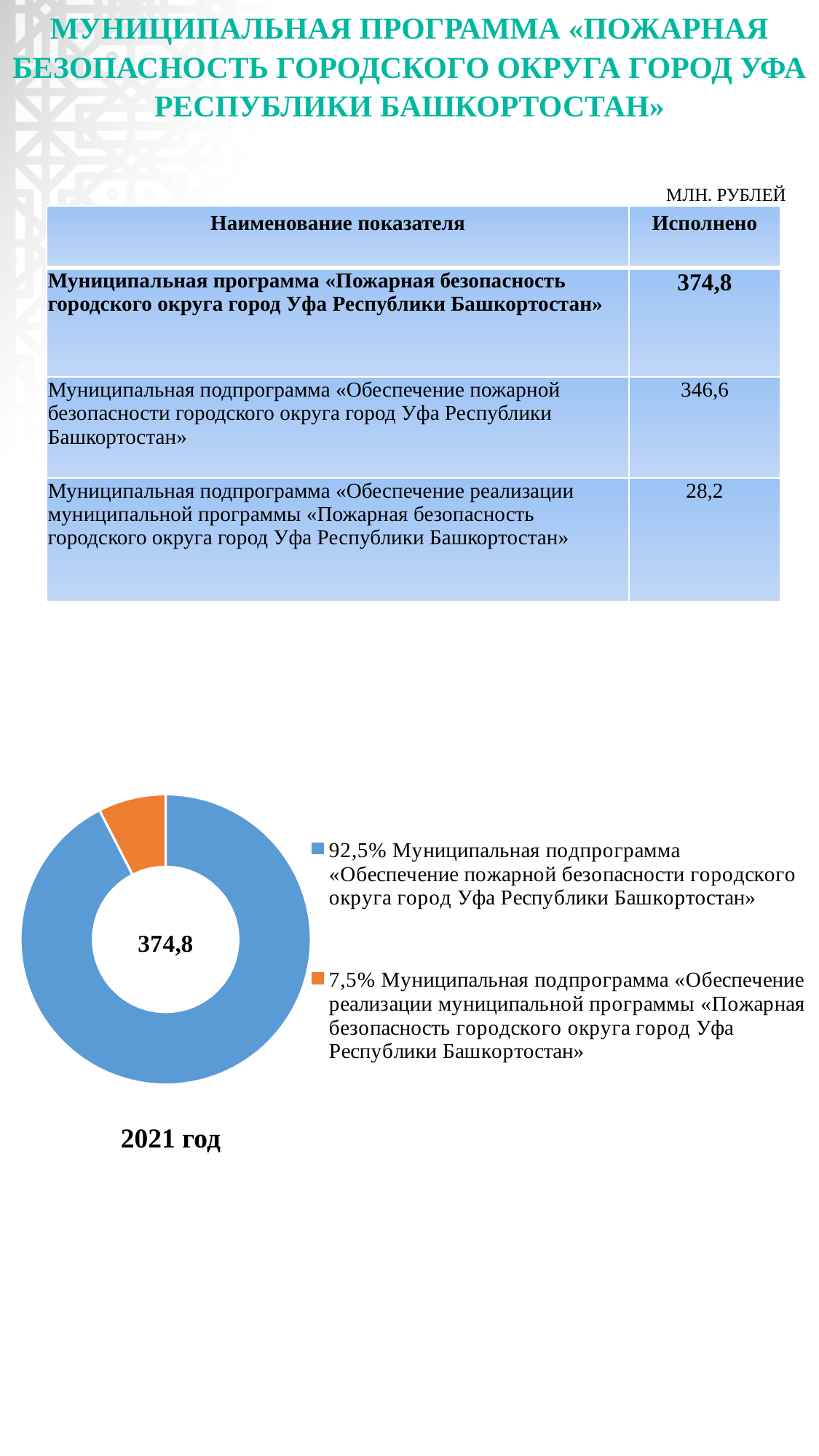
What share of the doughnut chart does the subprogram «Обеспечение реализации муниципальной программы «Пожарная безопасность городского округа город Уфа Республики Башкортостан» take? 7,5% What year is labelled under the doughnut chart? 2021 год What share of the doughnut chart does the subprogram «Обеспечение пожарной безопасности городского округа город Уфа Республики Башкортостан» take? 92,5% Which slice of the doughnut chart is the smallest? Муниципальная подпрограмма «Обеспечение реализации муниципальной программы «Пожарная безопасность городского округа город Уфа Республики Башкортостан» How many slices does the doughnut chart have? 2 How many entries does the legend of the doughnut chart list? 2 Which is larger in the doughnut chart: the share of the fire safety subprogram or the share of the program implementation subprogram? the fire safety subprogram (92,5%) What total value is printed in the centre of the doughnut chart? 374,8 Which slice of the doughnut chart is the largest? Муниципальная подпрограмма «Обеспечение пожарной безопасности городского округа город Уфа Республики Башкортостан» What kind of chart is shown at the bottom of the slide? doughnut chart What colour is the slice for the subprogram «Обеспечение реализации муниципальной программы...» in the doughnut chart? orange By how many percentage points does the share of the blue slice exceed the share of the orange slice in the doughnut chart? 85%